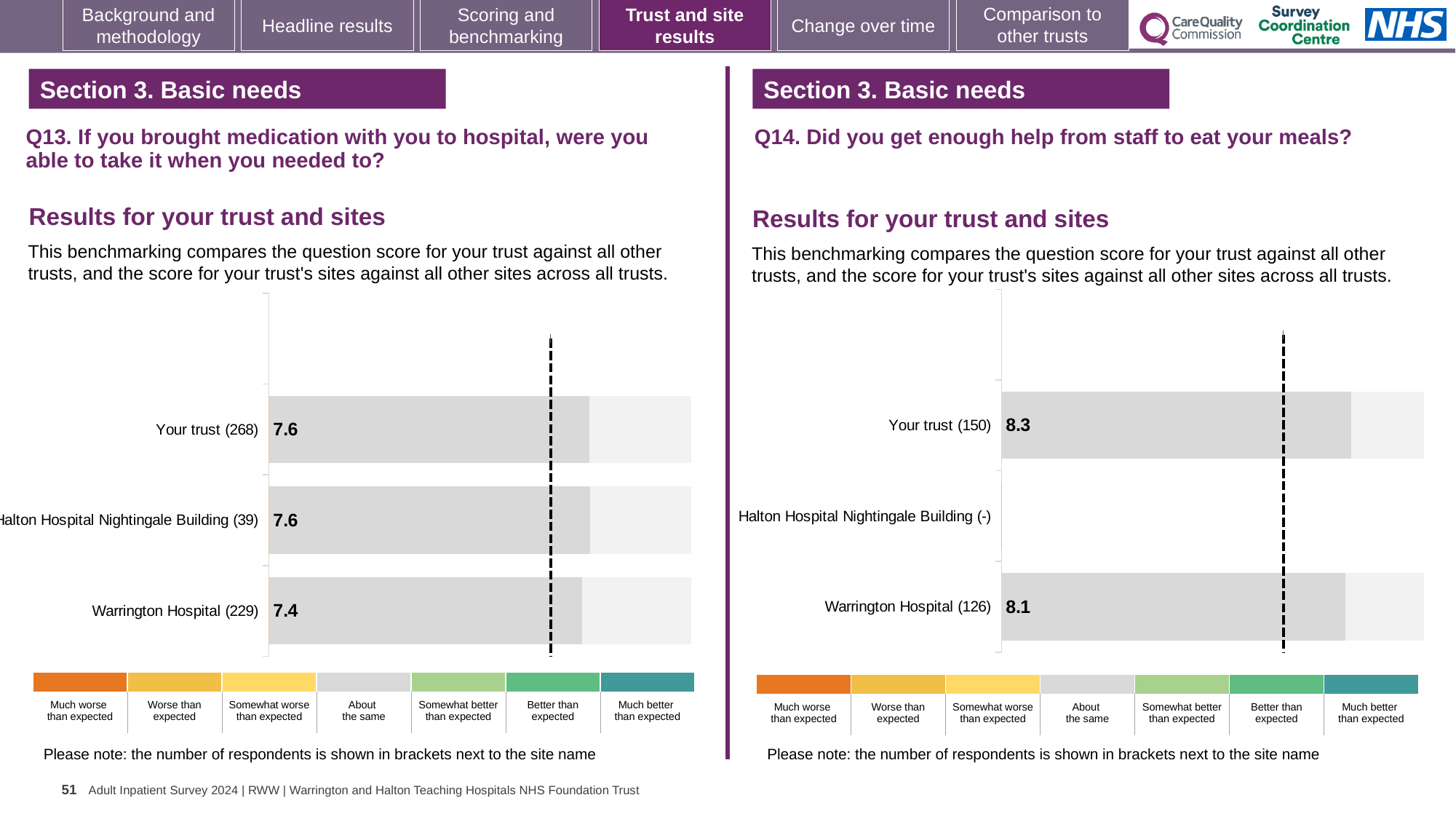
What kind of chart is used on the Q13 chart (left)? Bar chart On the Q13 chart (left), which site has the lowest score? Warrington Hospital On the Q14 chart (right), what is the score for Warrington Hospital? 8.1 On the Q14 chart (right), how many respondents are shown in brackets for Warrington Hospital? 126 On the Q13 chart (left), what is the difference between the score for Your trust and the score for Warrington Hospital? 0.2 On the Q14 chart (right), what is the difference between the score for Your trust and the score for Warrington Hospital? 0.2 On the Q13 chart (left), what is the score for Warrington Hospital? 7.4 On the Q13 chart (left), how many respondents are shown in brackets for Your trust? 268 On the Q14 chart (right), which is larger: the score for Your trust or the score for Warrington Hospital? Your trust On the Q13 chart (left), what is the score for Halton Hospital Nightingale Building? 7.6 On the Q13 chart (left), what is the score for Your trust? 7.6 On the Q14 chart (right), what is the score for Your trust? 8.3